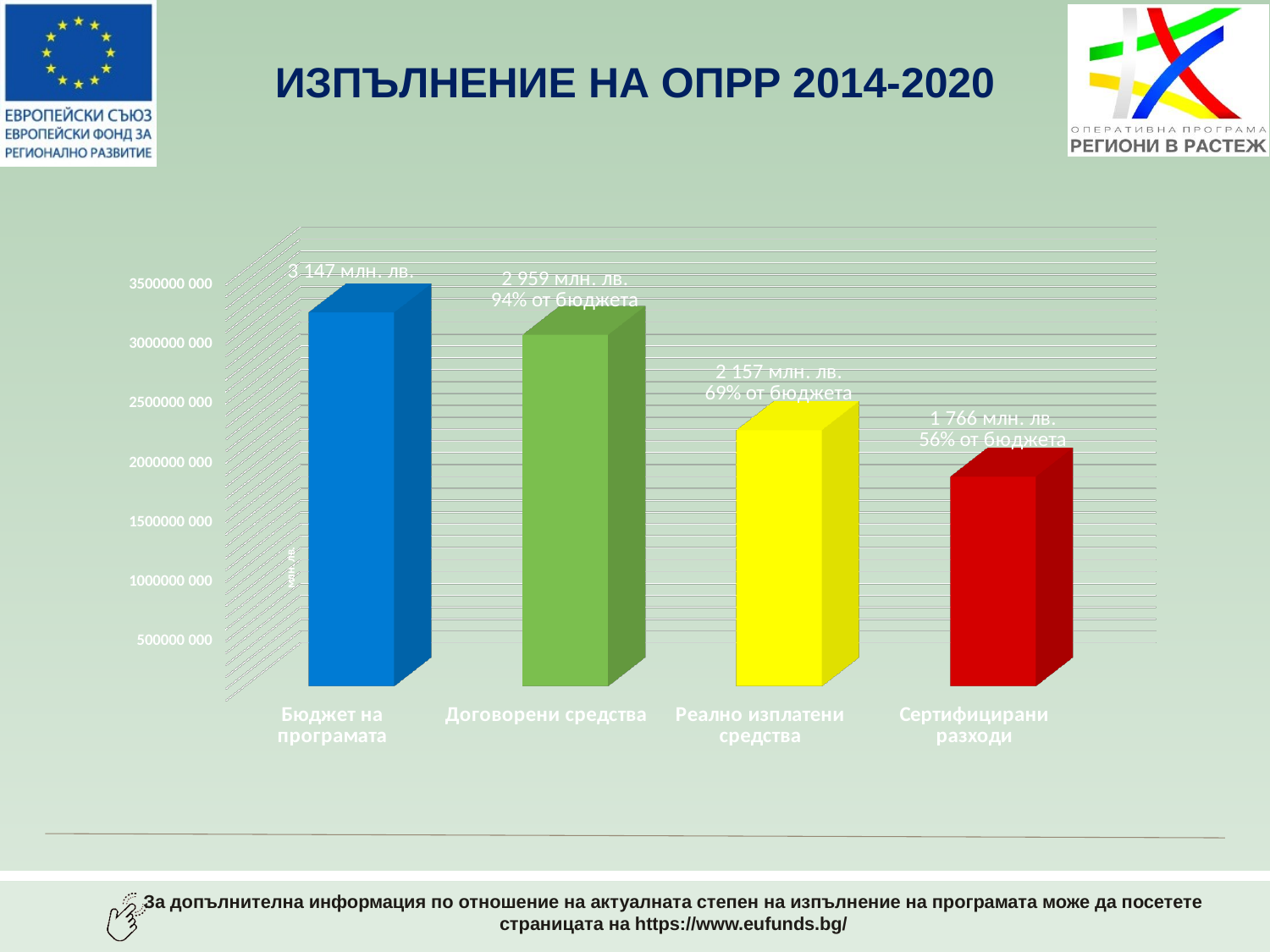
What value is shown for Договорени средства? 2 959 млн. лв. Which is larger, Договорени средства or Реално изплатени средства? Договорени средства How many categories are shown on the chart? 4 Which category has the lowest value? Сертифицирани разходи What value is shown for Бюджет на програмата? 3 147 млн. лв. What value is shown for Реално изплатени средства? 2 157 млн. лв. What is the difference between Бюджет на програмата and Договорени средства? 188 млн. лв. What percentage of the budget do the Сертифицирани разходи represent according to the data label? 56% от бюджета What value is shown for Сертифицирани разходи? 1 766 млн. лв. What is the difference between Реално изплатени средства and Сертифицирани разходи? 391 млн. лв. Which category has the highest value? Бюджет на програмата Do the values rise or fall from left to right along the x axis? fall